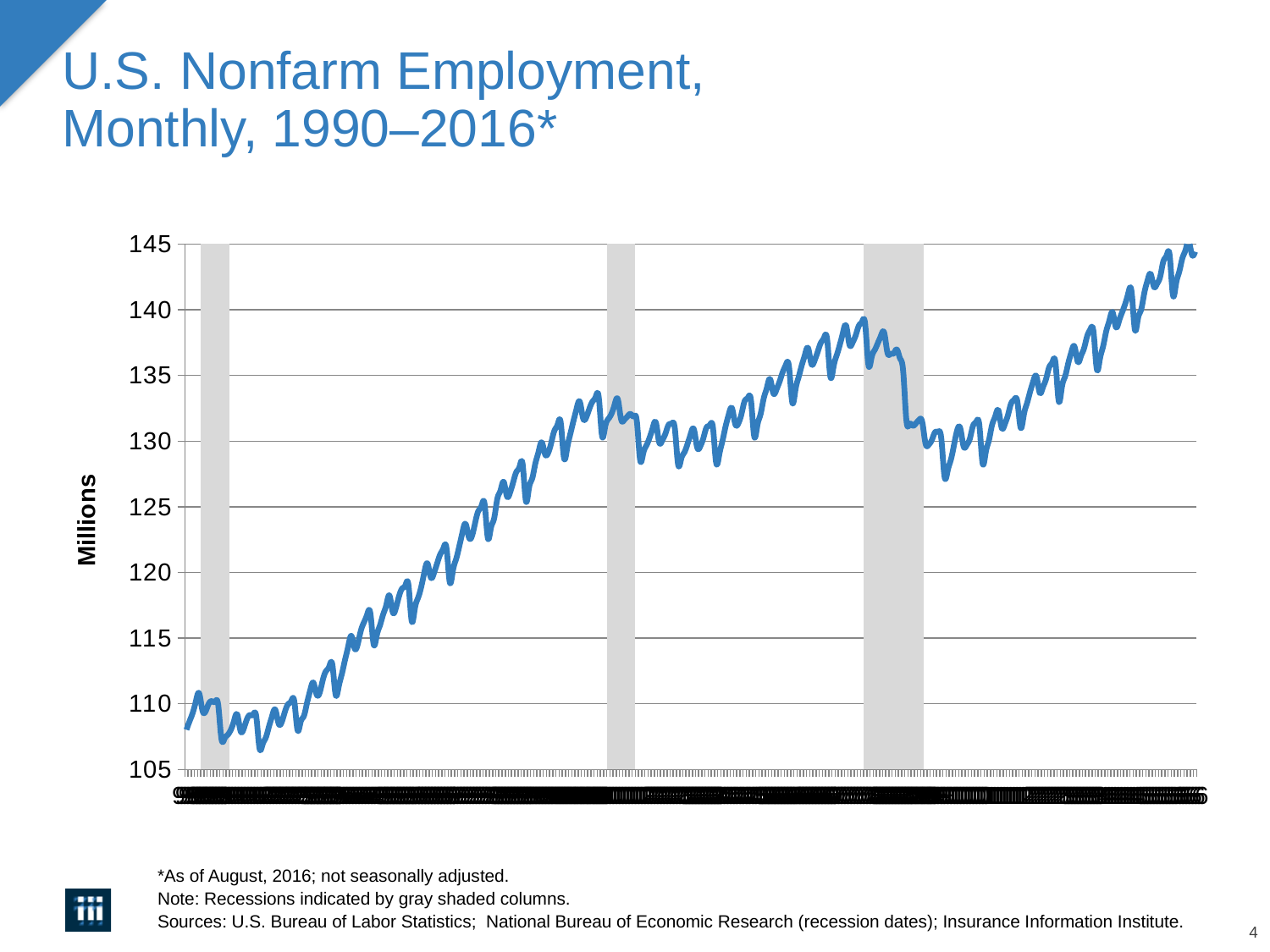
Is the value at the start of the series (far left) greater or less than 110? less Is the highest point of the line greater or less than 140? greater Is the value at the end of the series larger or smaller than the value at the start of the series? larger Is the value at the end of the series (far right) greater or less than 140? greater What is the title of the chart? U.S. Nonfarm Employment, Monthly, 1990–2016* Overall, do the values rise or fall from the left to the right of the chart? rise What kind of chart is shown on the slide? line chart What is the highest value shown on the vertical axis? 145 What is the label on the vertical axis of the chart? Millions